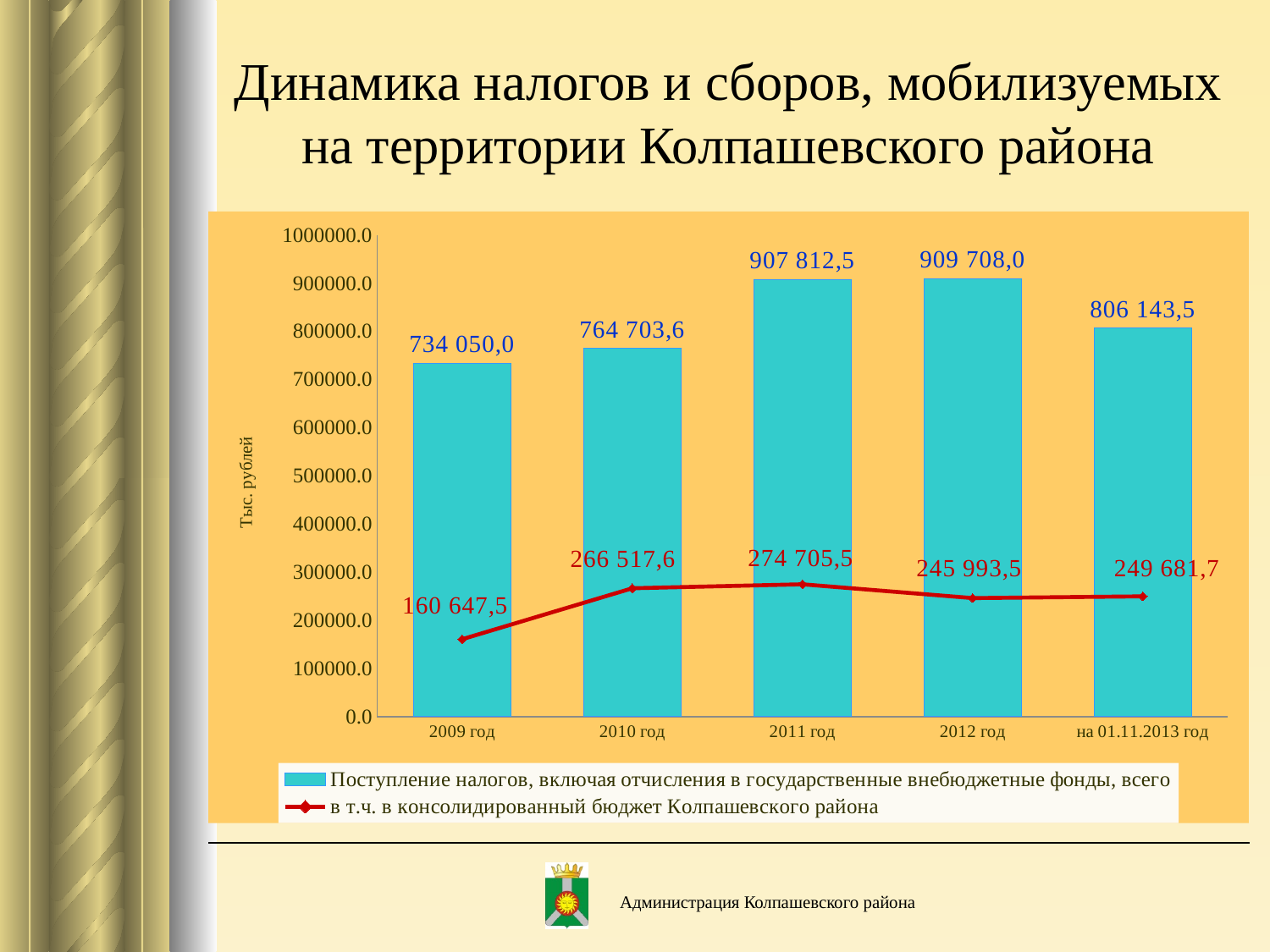
What is the value of the line series (в т.ч. в консолидированный бюджет Колпашевского района) for 2009 год? 160 647,5 Which category has the highest value in the bar series (Поступление налогов ... всего)? 2012 год What is the difference between the line values for 2010 год and 2009 год? 105 870,1 What is the value of the bar series for на 01.11.2013 год? 806 143,5 What is the value of the bar series (Поступление налогов, включая отчисления в государственные внебюджетные фонды, всего) for 2011 год? 907 812,5 How many categories are shown on the x axis? 5 What is the difference between the bar values for 2011 год and 2010 год? 143 108,9 Which category has the lowest value in the line series (в т.ч. в консолидированный бюджет Колпашевского района)? 2009 год How many series does the legend list? 2 What kind of chart is shown on the slide? Combined bar and line chart Which is larger: the bar value for 2010 год or the bar value for на 01.11.2013 год? на 01.11.2013 год Which category has the highest value in the line series (в т.ч. в консолидированный бюджет Колпашевского района)? 2011 год